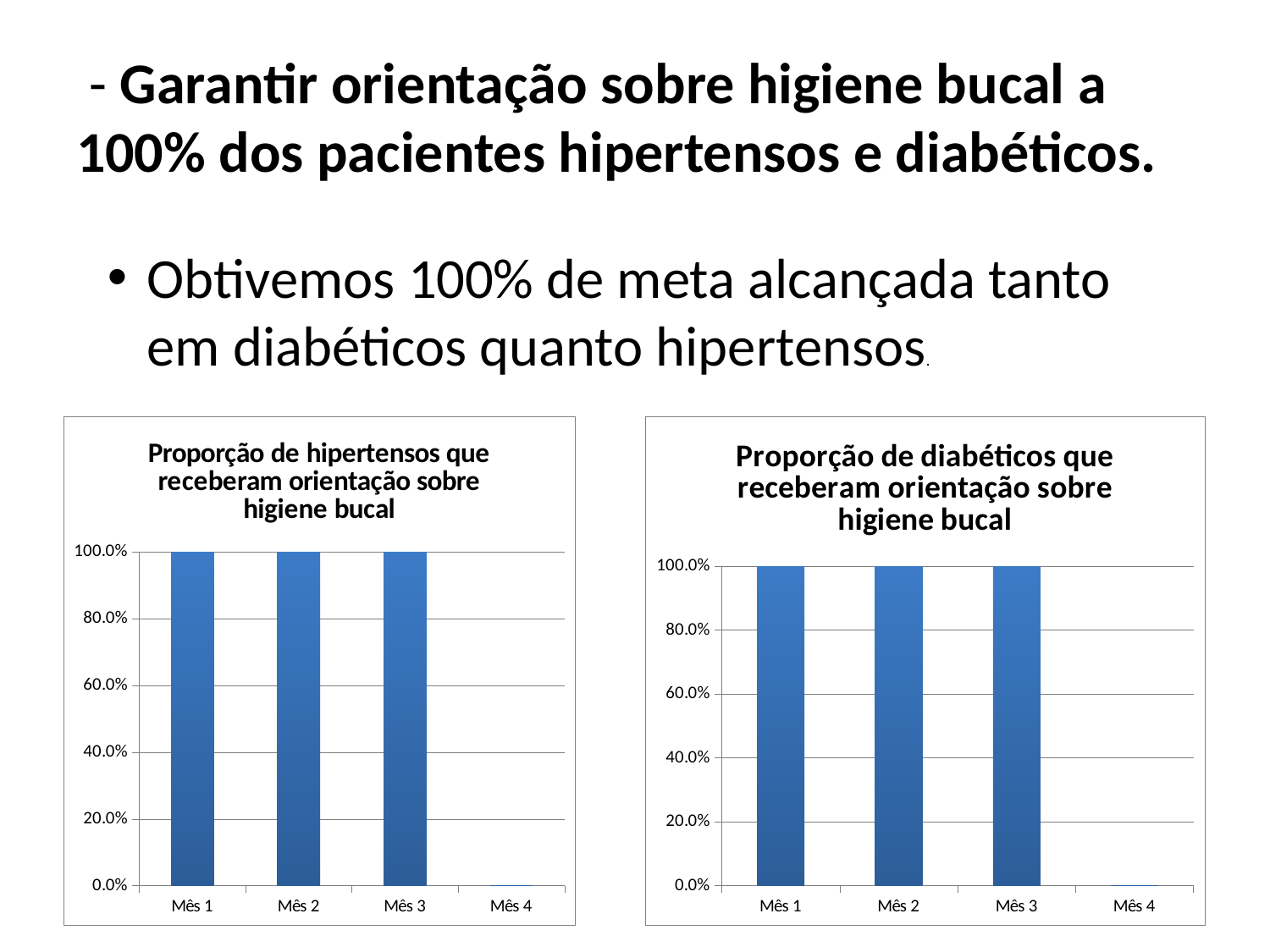
In the chart titled 'Proporção de diabéticos que receberam orientação sobre higiene bucal', is the value for Mês 2 larger or smaller than the value for Mês 4? larger In the chart titled 'Proporção de hipertensos que receberam orientação sobre higiene bucal', what is the value for Mês 4? 0.0% In the chart titled 'Proporção de hipertensos que receberam orientação sobre higiene bucal', which category has the lowest value? Mês 4 In the chart titled 'Proporção de diabéticos que receberam orientação sobre higiene bucal', which category has the lowest value? Mês 4 What kind of chart is the chart titled 'Proporção de diabéticos que receberam orientação sobre higiene bucal'? bar chart In the chart titled 'Proporção de hipertensos que receberam orientação sobre higiene bucal', what is the difference between the values for Mês 1 and Mês 4? 100.0% In the chart titled 'Proporção de diabéticos que receberam orientação sobre higiene bucal', is the value for Mês 4 greater or less than 20.0%? less In the chart titled 'Proporção de diabéticos que receberam orientação sobre higiene bucal', what is the value for Mês 3? 100.0% How many charts are shown on the slide? 2 In the chart titled 'Proporção de hipertensos que receberam orientação sobre higiene bucal', what is the value for Mês 1? 100.0% In the chart titled 'Proporção de hipertensos que receberam orientação sobre higiene bucal', is the value for Mês 2 greater or less than 80.0%? greater How many categories are shown on the x axis of the chart titled 'Proporção de hipertensos que receberam orientação sobre higiene bucal'? 4